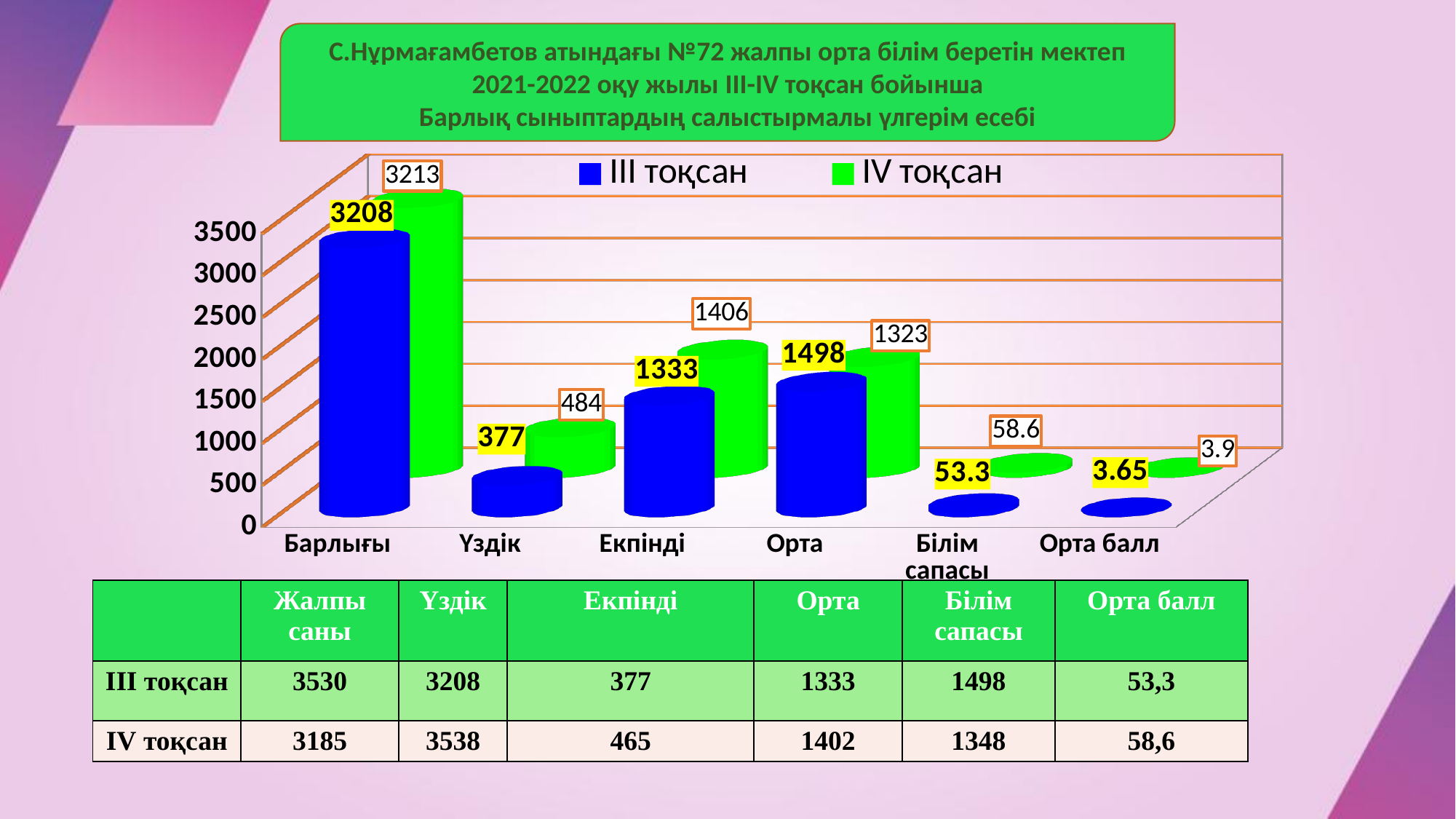
What is the difference between the IV тоқсан and III тоқсан values for Үздік? 107 Which category has the highest value in the III тоқсан series? Барлығы How many series does the chart legend list? 2 What is the value for Барлығы in the III тоқсан series? 3208 What kind of chart is shown on the slide? Bar chart What is the value for Үздік in the IV тоқсан series? 484 How many categories are shown on the x axis of the chart? 6 Which category has the lowest value in the IV тоқсан series? Орта балл What is the value for Барлығы in the IV тоқсан series? 3213 What is the value for Білім сапасы in the IV тоқсан series? 58.6 For Орта, which series has the larger value, III тоқсан or IV тоқсан? III тоқсан What is the value for Орта балл in the III тоқсан series? 3.65